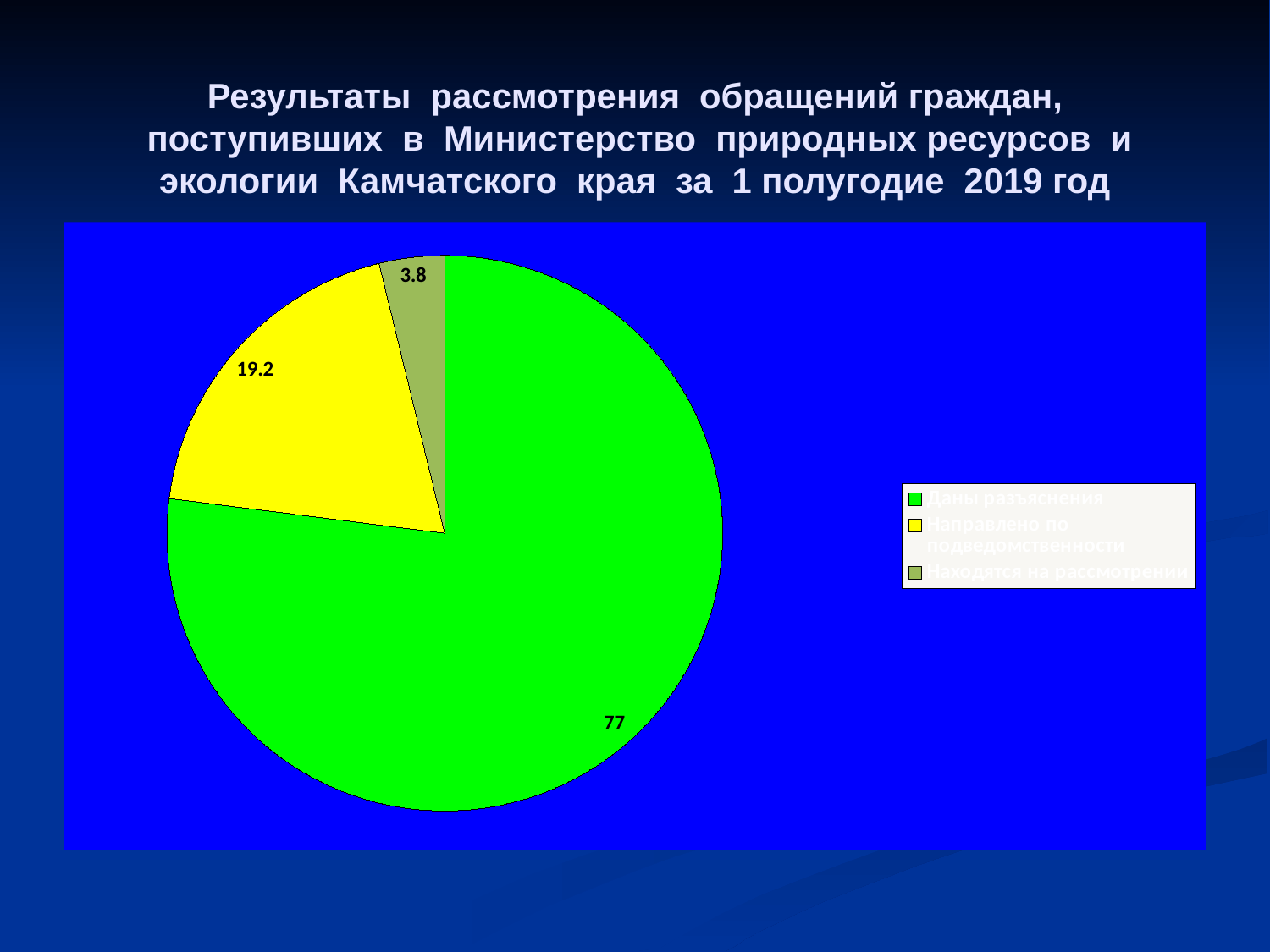
Which category has the smallest slice of the pie? Находятся на рассмотрении What type of chart is shown on the slide? pie chart What is the value shown for the yellow slice (Направлено по подведомственности)? 19.2 What is the difference between the values for Направлено по подведомственности and Находятся на рассмотрении? 15.4 Which category has the largest slice of the pie? Даны разъяснения How many slices does the pie chart have? 3 What is the value shown for the green slice (Даны разъяснения)? 77 How many entries does the legend list? 3 What colour is the slice for Направлено по подведомственности? yellow What is the value shown for the slice labelled Находятся на рассмотрении? 3.8 Which is larger: the value for Направлено по подведомственности or the value for Находятся на рассмотрении? Направлено по подведомственности What is the difference between the values for Даны разъяснения and Направлено по подведомственности? 57.8